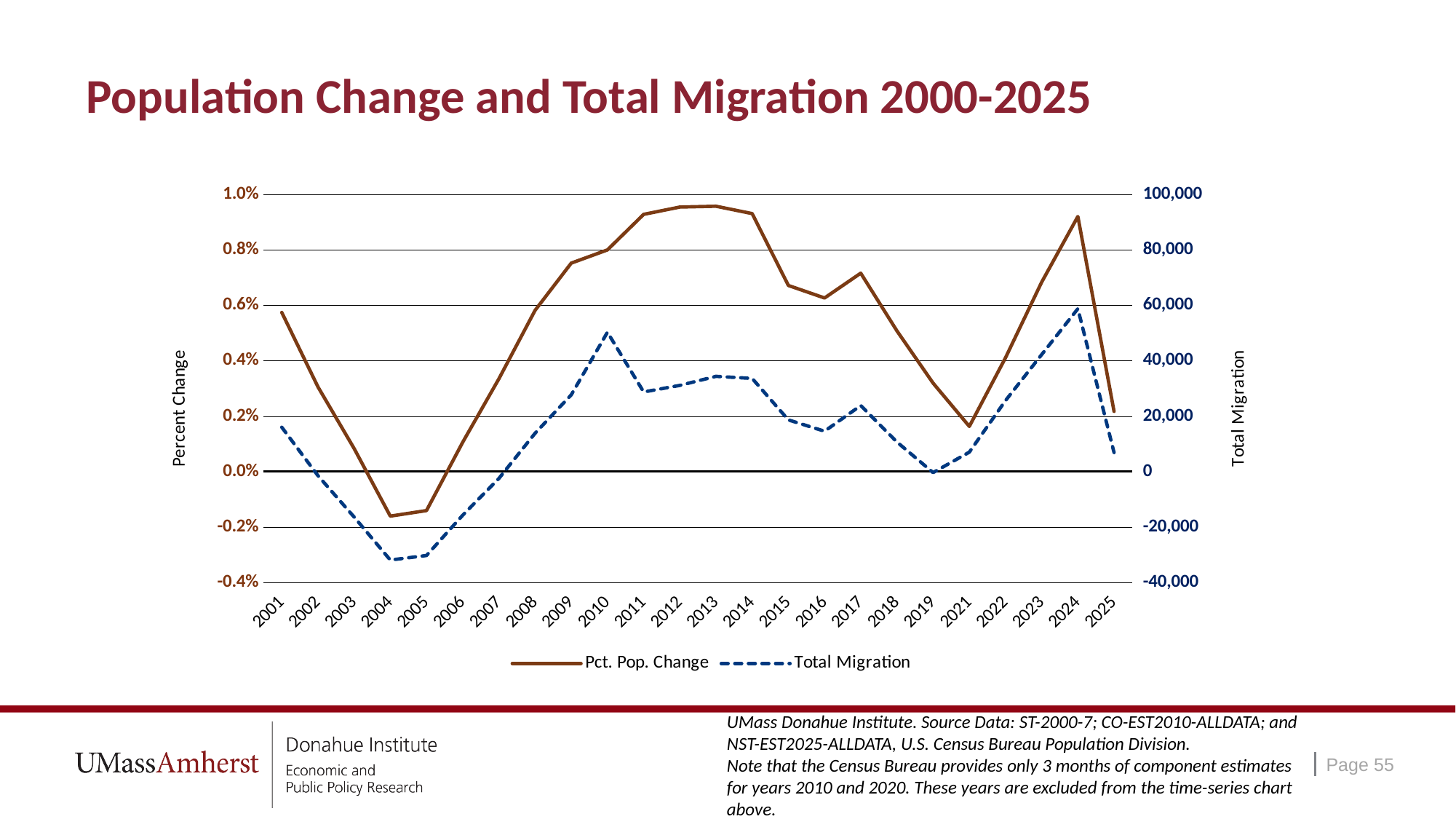
What kind of chart is shown on the slide? Line chart How many years are labelled on the x axis? 24 Is the Total Migration value for 2010 greater or less than 40,000? greater How many series does the legend list? 2 Which is larger for Pct. Pop. Change, the value for 2001 or the value for 2004? 2001 Is the Total Migration value for 2004 greater or less than -20,000? less Which is larger for Total Migration, the value for 2010 or the value for 2011? 2010 Is the Pct. Pop. Change value for 2021 greater or less than 0.2%? less Which year has the highest Total Migration value? 2024 Does the Pct. Pop. Change line rise or fall from 2004 to 2013? rise What is the title of the right-hand vertical axis? Total Migration